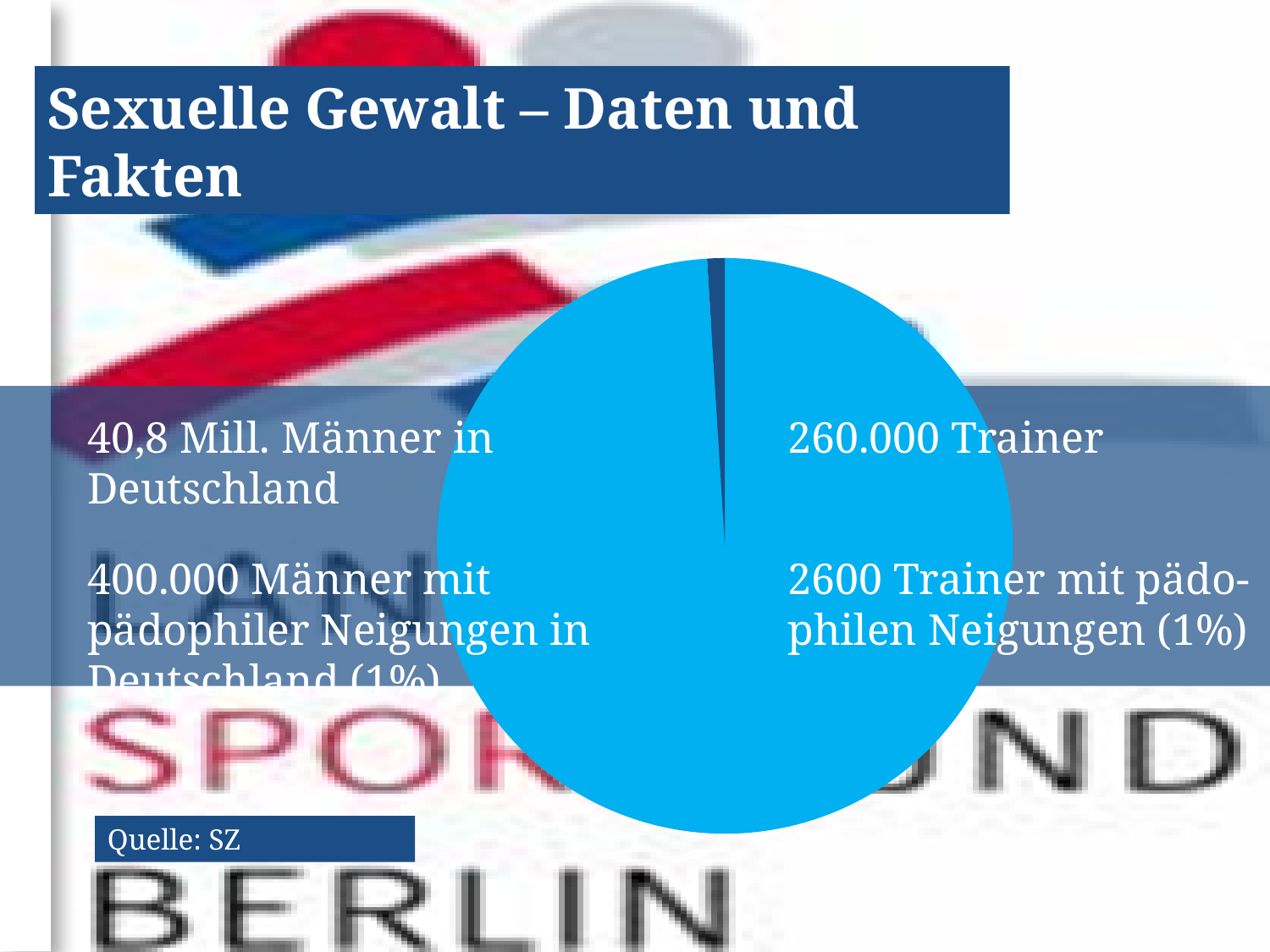
Which slice of the pie chart is larger, the light blue one or the dark blue one? the light blue one What kind of chart is shown on the slide? pie chart How many slices does the pie chart have? 2 What source is given on the slide for the data? Quelle: SZ What share of the pie does the small dark blue slice represent, according to the slide? 1% According to the slide, how many Männer in Deutschland are there? 40,8 Mill. According to the slide, how many Trainer mit pädophilen Neigungen are there? 2600 According to the slide, how many Männer mit pädophiler Neigungen in Deutschland are there? 400.000 According to the slide, how many Trainer are there? 260.000 What is the title of the slide containing the pie chart? Sexuelle Gewalt – Daten und Fakten